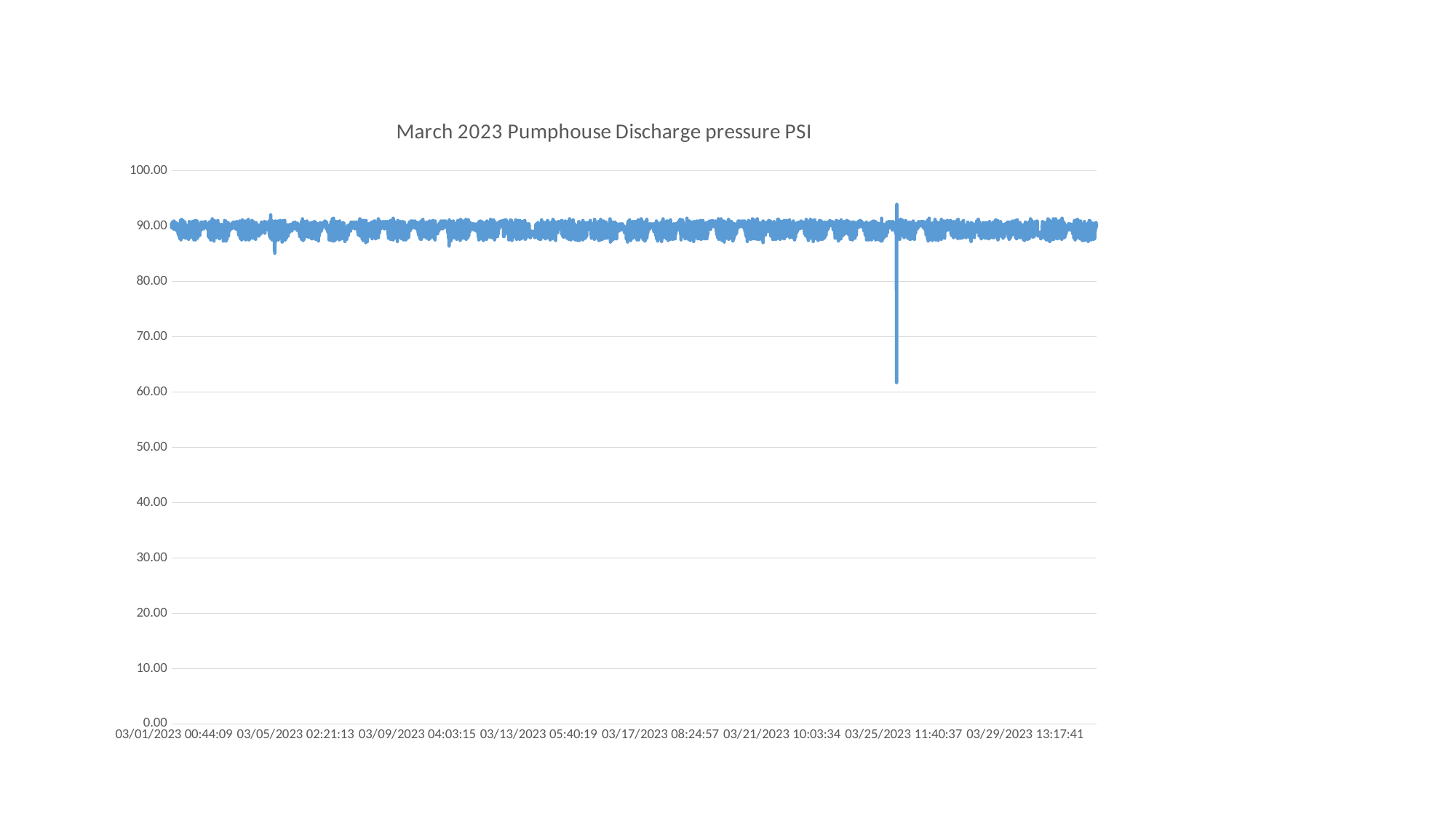
Is the pressure for most of March greater or less than 80.00? greater How many date labels are shown along the x axis? 8 What is the highest tick value shown on the y axis? 100.00 What is the title of the chart? March 2023 Pumphouse Discharge pressure PSI What kind of chart is shown on the slide? line chart What is the interval between consecutive y-axis tick labels? 10.00 Is the highest value plotted on the chart greater or less than 100.00? less What is the first date label on the x axis? 03/01/2023 00:44:09 Apart from the brief spike, does the pressure rise, fall, or stay roughly flat across March? roughly flat How many lines are plotted on the chart? 1 Is the lowest value plotted on the chart greater or less than 70.00? less Which x-axis date label is closest to the sharp downward spike in the line? 03/25/2023 11:40:37